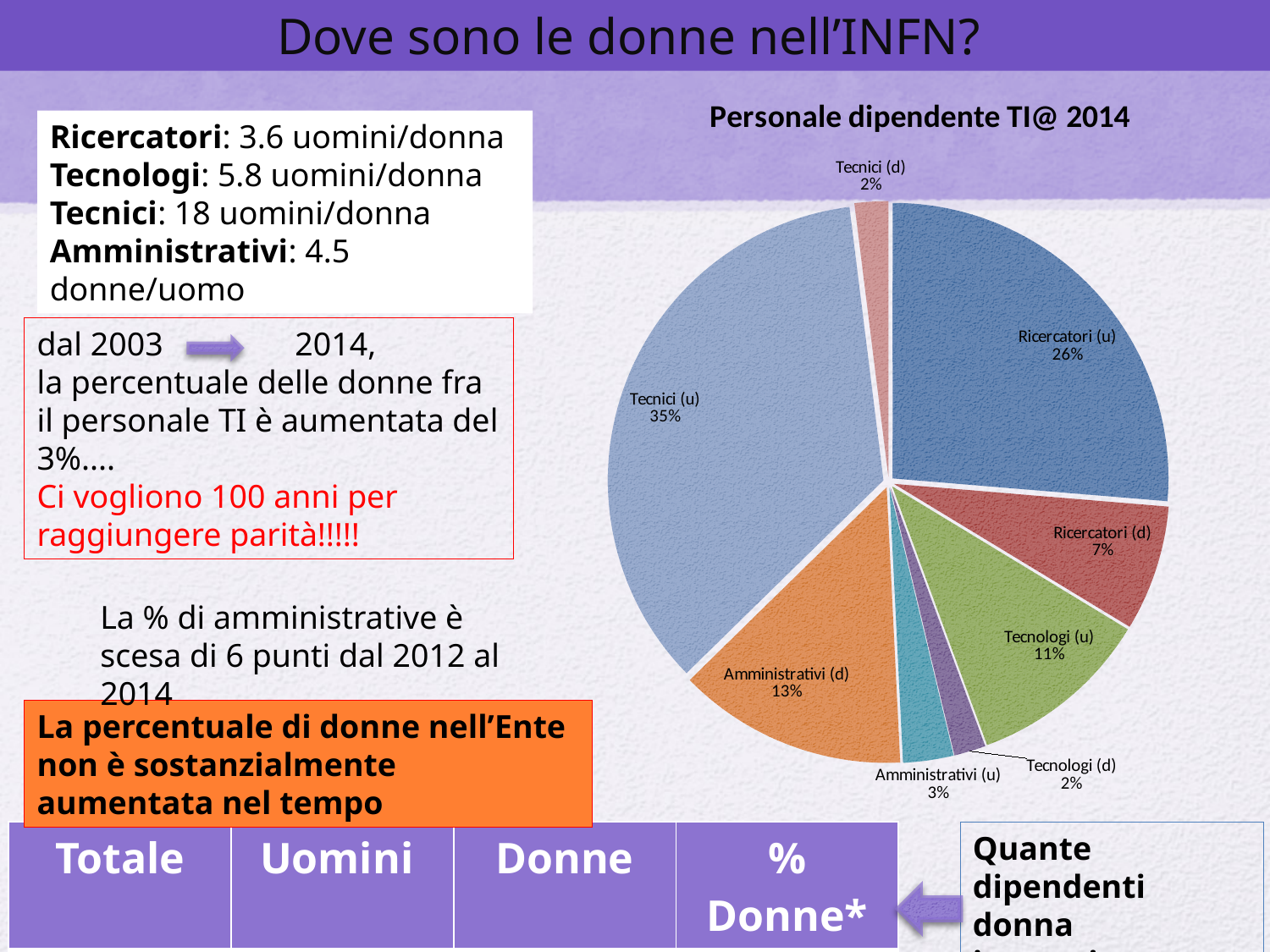
What share of the pie is Ricercatori (u)? 26% Which category has the largest slice of the pie? Tecnici (u) What kind of chart is shown on the slide? pie chart What share of the pie is Amministrativi (d)? 13% What is the title of the chart? Personale dipendente TI@ 2014 What share of the pie is Tecnici (u)? 35% Which is larger, the slice for Ricercatori (u) or the slice for Amministrativi (d)? Ricercatori (u) What is the difference in percentage points between the Amministrativi (d) slice and the Amministrativi (u) slice? 10 What is the difference in percentage points between the Tecnici (u) slice and the Ricercatori (u) slice? 9 How many slices does the pie chart have? 8